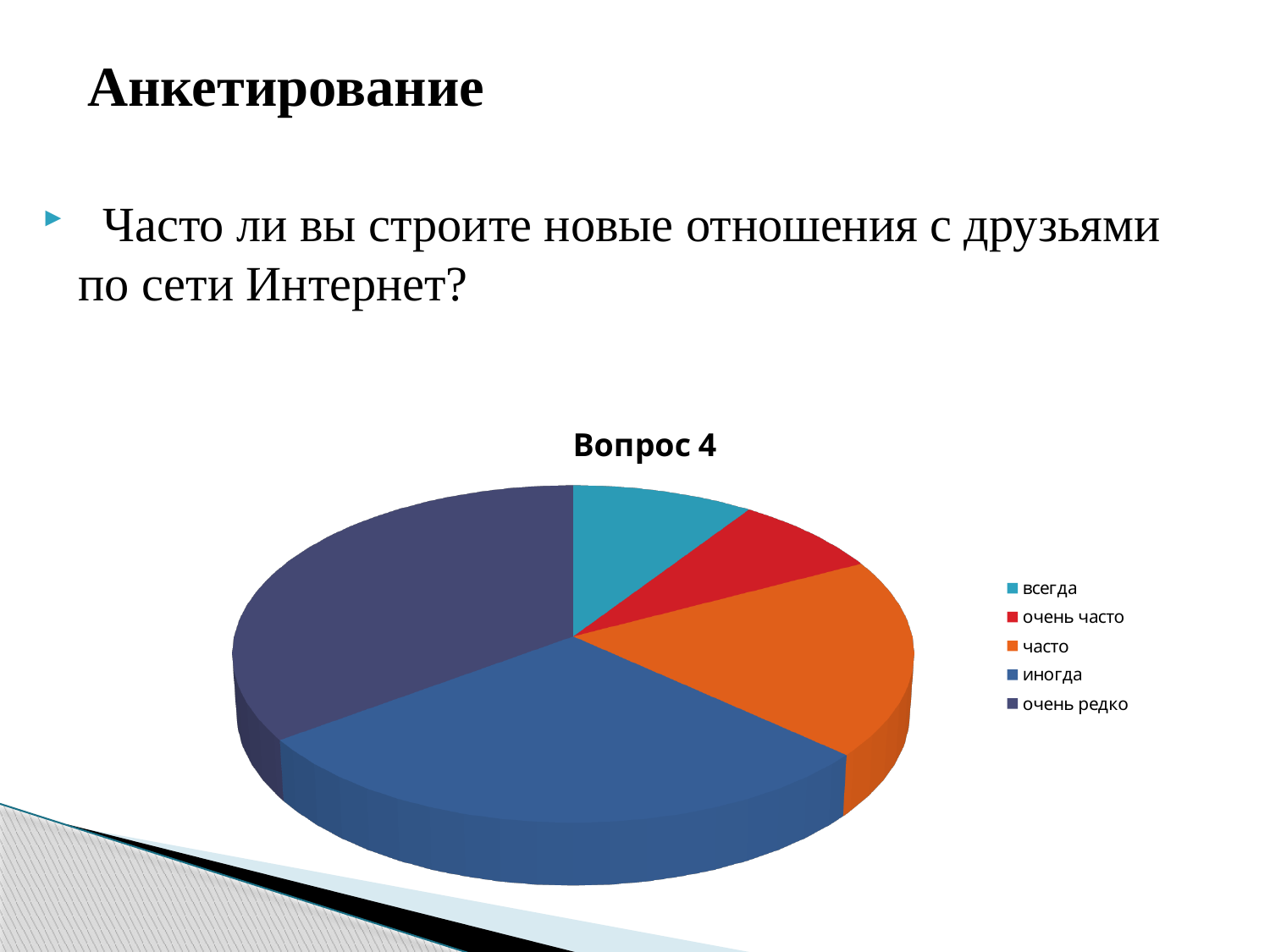
What kind of chart is shown on the slide? pie chart Which slice is larger, "иногда" or "часто"? иногда Which slice is larger, "очень редко" or "очень часто"? очень редко Which slice is larger, "иногда" or "всегда"? иногда Which colour represents "очень часто" in the legend? red How many slices does the pie chart have? 5 What is the title of the chart? Вопрос 4 How many entries does the legend list? 5